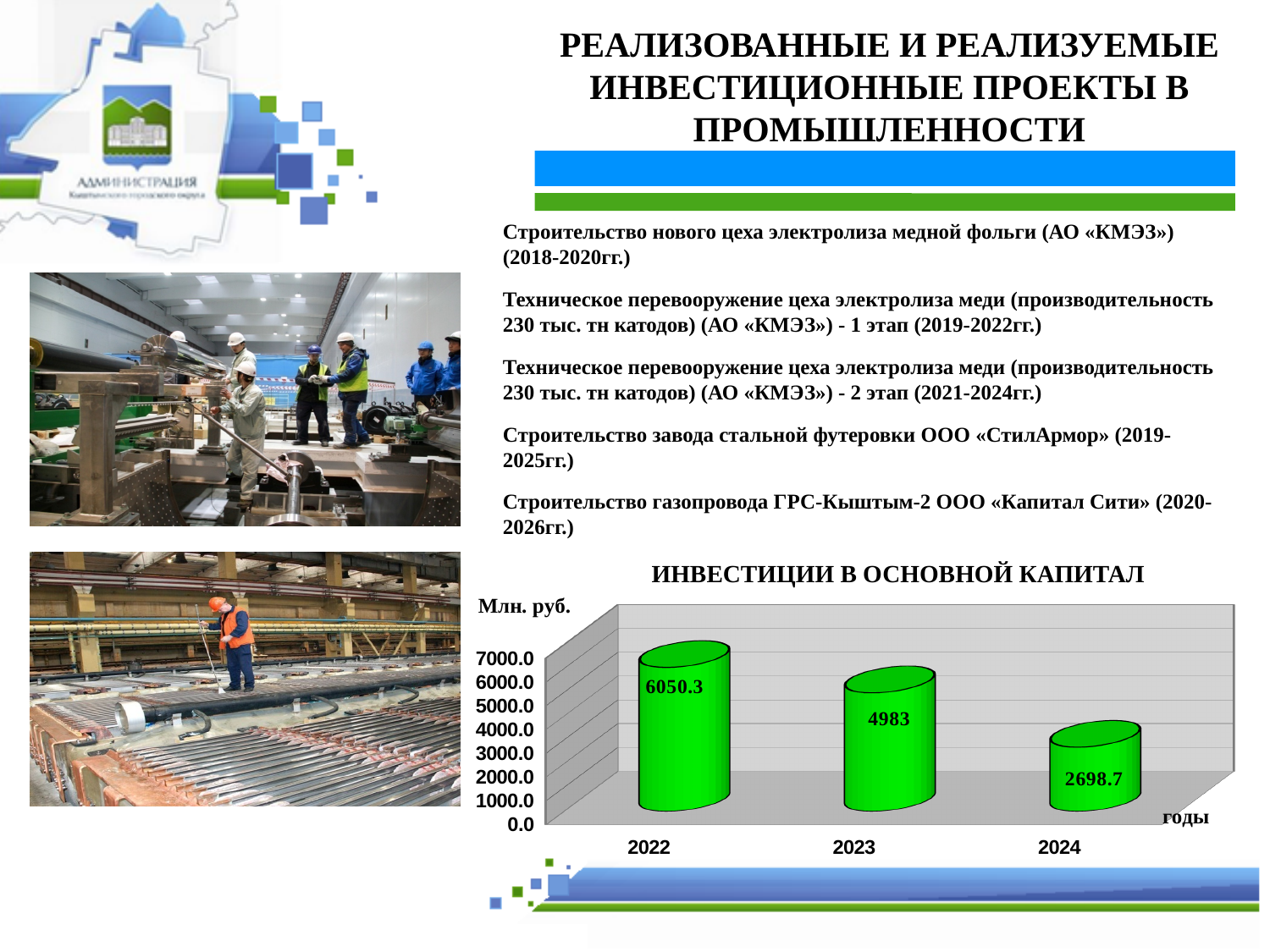
Which is larger in the chart 'ИНВЕСТИЦИИ В ОСНОВНОЙ КАПИТАЛ', the value for 2023 or the value for 2024? 2023 What is the value for 2023 in the chart 'ИНВЕСТИЦИИ В ОСНОВНОЙ КАПИТАЛ'? 4983 Which year has the highest value in the chart 'ИНВЕСТИЦИИ В ОСНОВНОЙ КАПИТАЛ'? 2022 What is the value for 2022 in the chart 'ИНВЕСТИЦИИ В ОСНОВНОЙ КАПИТАЛ'? 6050.3 What is the difference between the values for 2022 and 2023 in the chart 'ИНВЕСТИЦИИ В ОСНОВНОЙ КАПИТАЛ'? 1067.3 What kind of chart is 'ИНВЕСТИЦИИ В ОСНОВНОЙ КАПИТАЛ'? bar chart How many years are shown in the chart 'ИНВЕСТИЦИИ В ОСНОВНОЙ КАПИТАЛ'? 3 Which year has the lowest value in the chart 'ИНВЕСТИЦИИ В ОСНОВНОЙ КАПИТАЛ'? 2024 What unit is shown on the vertical axis of the chart 'ИНВЕСТИЦИИ В ОСНОВНОЙ КАПИТАЛ'? Млн. руб. What is the value for 2024 in the chart 'ИНВЕСТИЦИИ В ОСНОВНОЙ КАПИТАЛ'? 2698.7 Do the values in the chart 'ИНВЕСТИЦИИ В ОСНОВНОЙ КАПИТАЛ' rise or fall from 2022 to 2024? fall What is the difference between the values for 2023 and 2024 in the chart 'ИНВЕСТИЦИИ В ОСНОВНОЙ КАПИТАЛ'? 2284.3